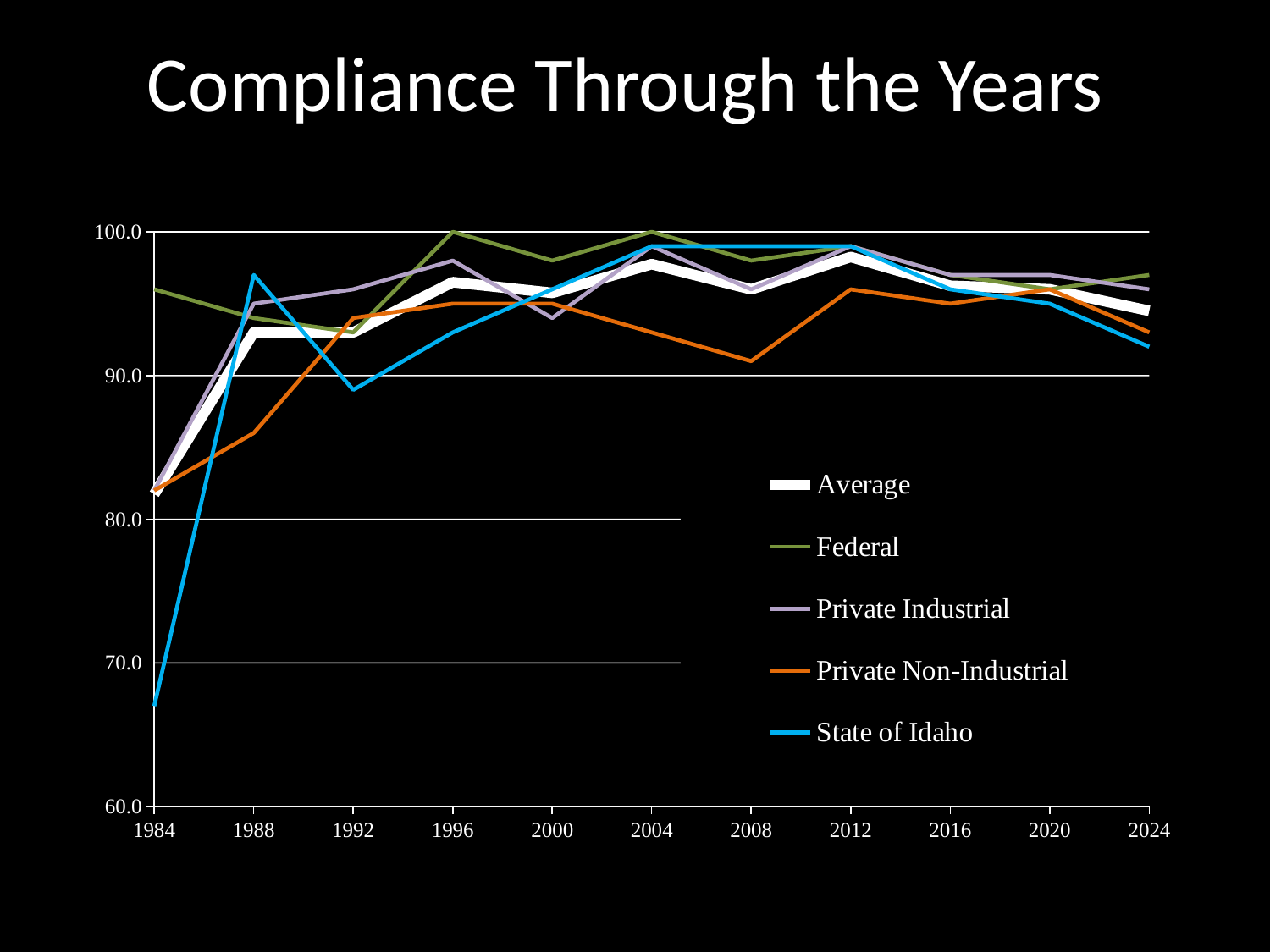
Is the value for Private Industrial in 1988 greater or less than 90.0? greater What is the title of the chart? Compliance Through the Years Which series is drawn with the thick white line? Average Which series has the lowest value in 1984? State of Idaho Which series has the highest value in 1984? Federal Is the value for Federal in 1984 greater or less than 90.0? greater Does the State of Idaho line rise or fall from 1984 to 1988? rise How many year labels are shown along the x axis? 11 Is the value for Private Non-Industrial in 1984 greater or less than 80.0? greater How many series does the legend list? 5 What kind of chart is shown on the slide? line chart